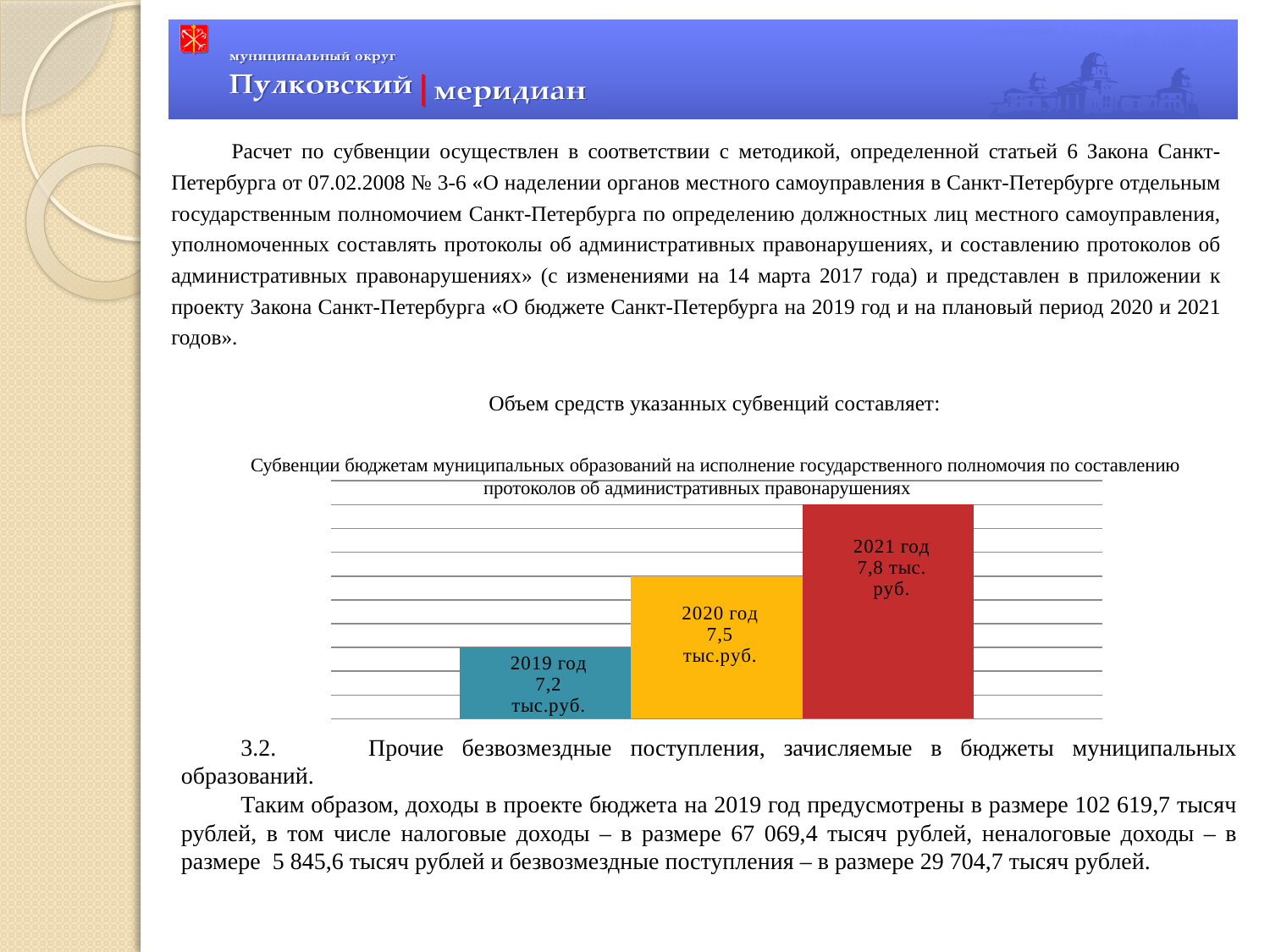
Which year has the lowest value? 2019 год What kind of chart is shown on the slide? bar chart What is the value for 2021 год? 7,8 тыс. руб. What is the difference between the values for 2021 год and 2019 год? 0,6 тыс.руб. Which is larger, the value for 2020 год or the value for 2021 год? 2021 год Which year has the highest value? 2021 год What is the difference between the values for 2020 год and 2019 год? 0,3 тыс.руб. What is the value for 2019 год? 7,2 тыс.руб. Do the values rise or fall from 2019 год to 2021 год? rise What colour is the bar for 2021 год? red What is the value for 2020 год? 7,5 тыс.руб. How many bars are shown in the chart? 3